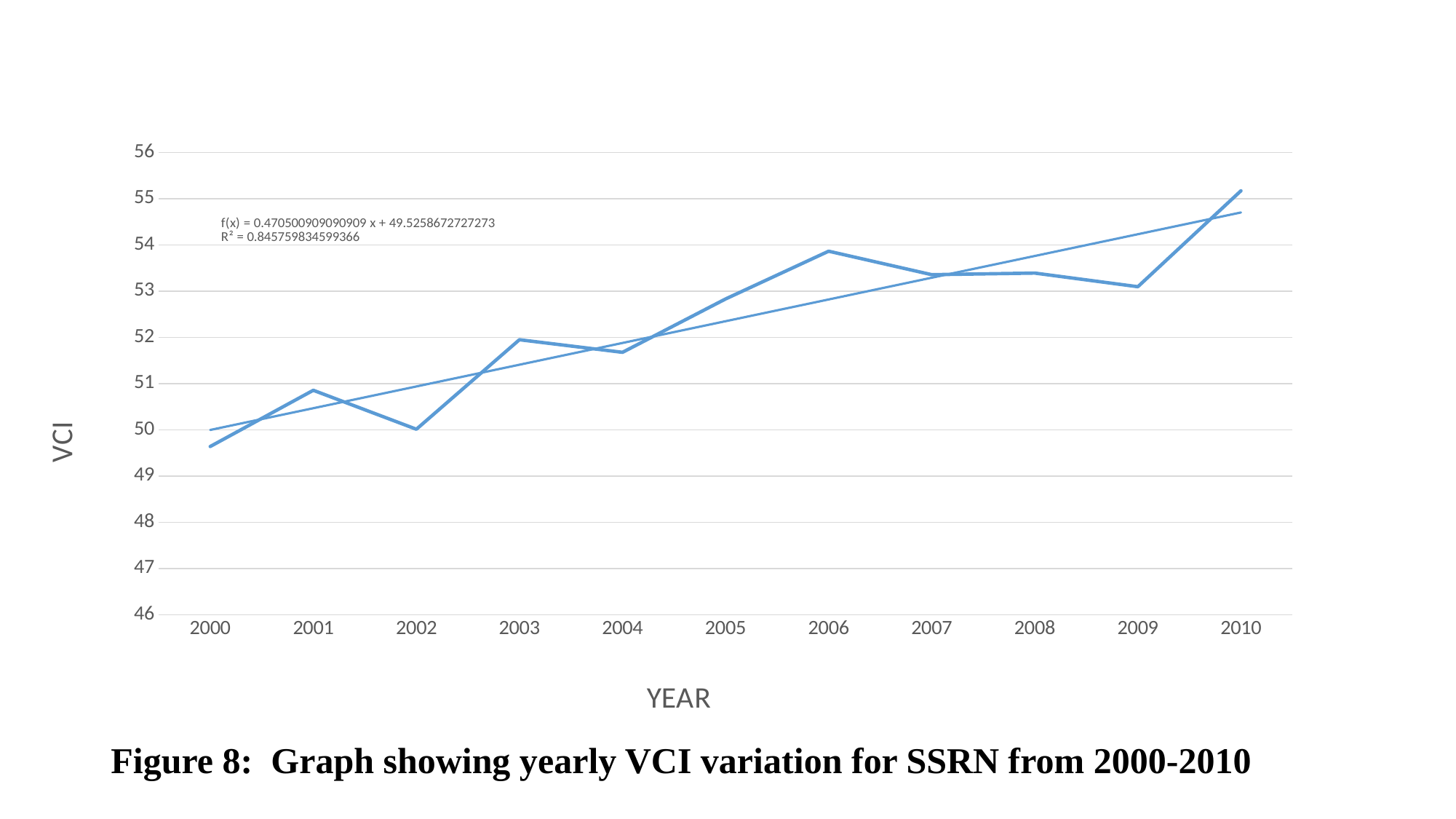
Is the VCI value for 2000 greater or less than 50? less Which year has a higher VCI value, 2006 or 2003? 2006 Which year has the highest VCI value? 2010 Is the VCI value for 2006 greater or less than 53? greater What is the title of the x axis? YEAR Overall, do the VCI values rise or fall from 2000 to 2010? rise What R² value is printed for the trendline on the chart? 0.845759834599366 Which year has the lowest VCI value? 2000 How many years are plotted along the x axis? 11 What kind of chart is shown on the slide? line chart Is the VCI value for 2004 greater or less than 52? less